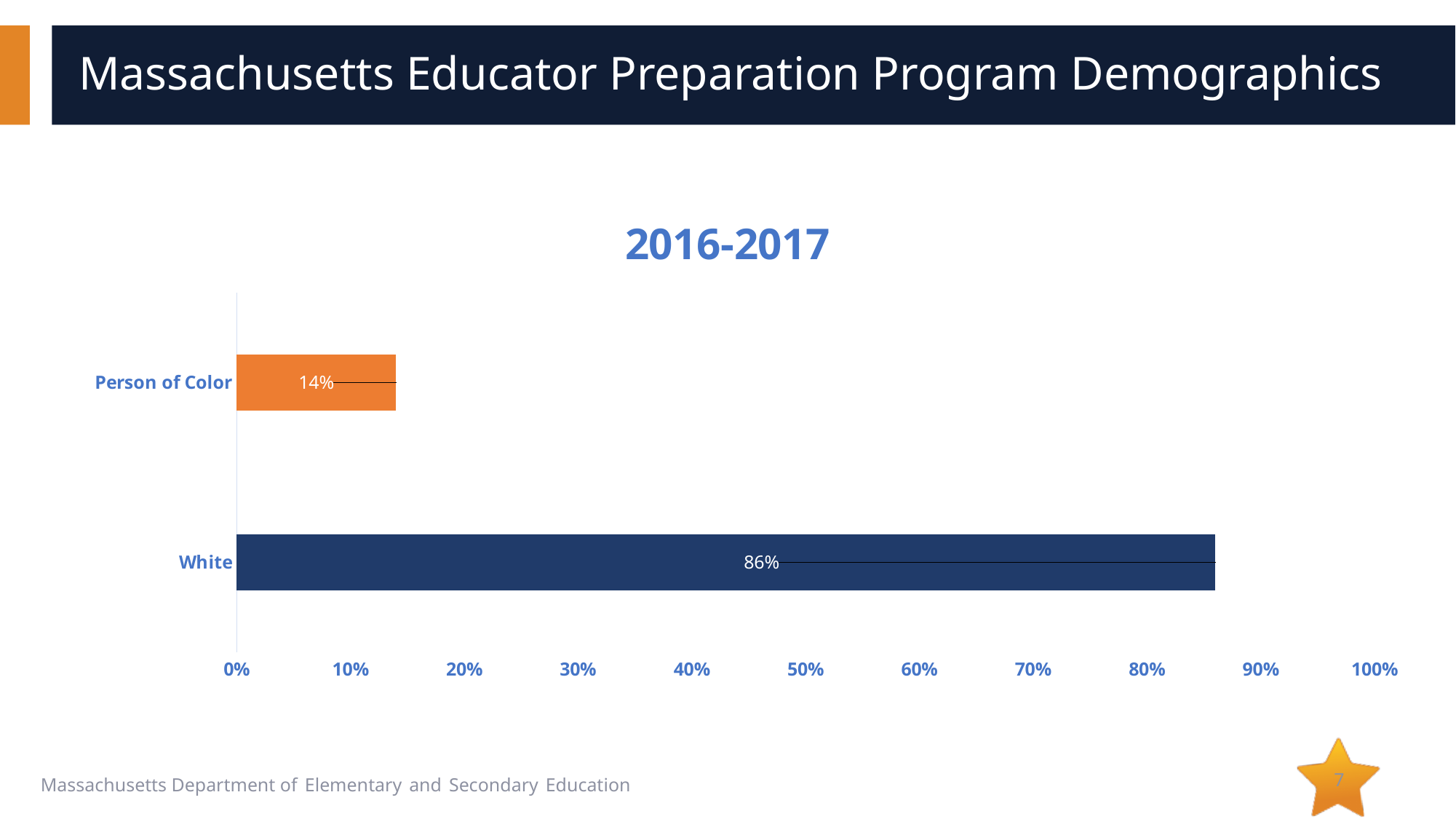
What is the value for White? 86% Is the value for Person of Color greater or less than 20%? less Which category has the highest value? White What is the title of the chart? 2016-2017 How many categories are shown in the chart? 2 Is the value for White greater or less than 80%? greater What kind of chart is shown on the slide? Bar chart What colour is the bar for Person of Color? Orange Which is larger, the value for White or the value for Person of Color? White What is the value for Person of Color? 14% What is the difference between the values for White and Person of Color? 72% Which category has the lowest value? Person of Color